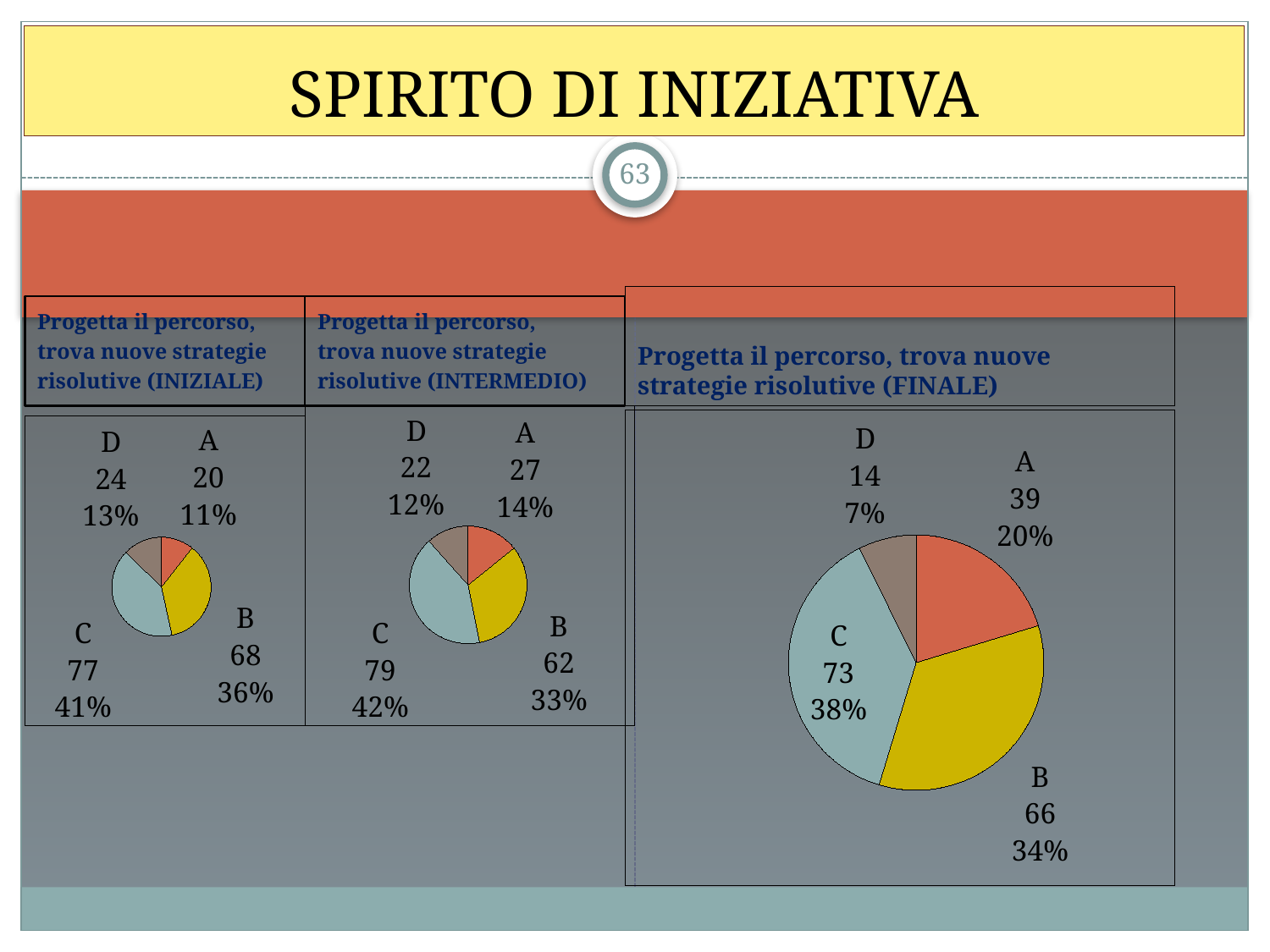
In the INTERMEDIO pie chart, which category has the highest value? C In the INIZIALE pie chart, what is the value for category C? 77 In the FINALE pie chart, what share of the pie does category C have? 38% In the FINALE pie chart, what is the value for category D? 14 In the INTERMEDIO pie chart, what is the value for category A? 27 In the INIZIALE pie chart, what share of the pie does category B have? 36% In the FINALE pie chart, which is larger, the value for A or the value for B? B What is the difference between the value for A in the FINALE chart and the value for A in the INIZIALE chart? 19 In the INTERMEDIO pie chart, what is the difference between the values for C and B? 17 In the INIZIALE pie chart, which category has the lowest value? A How many categories does the FINALE pie chart show? 4 What kind of chart is used in the INIZIALE panel? Pie chart